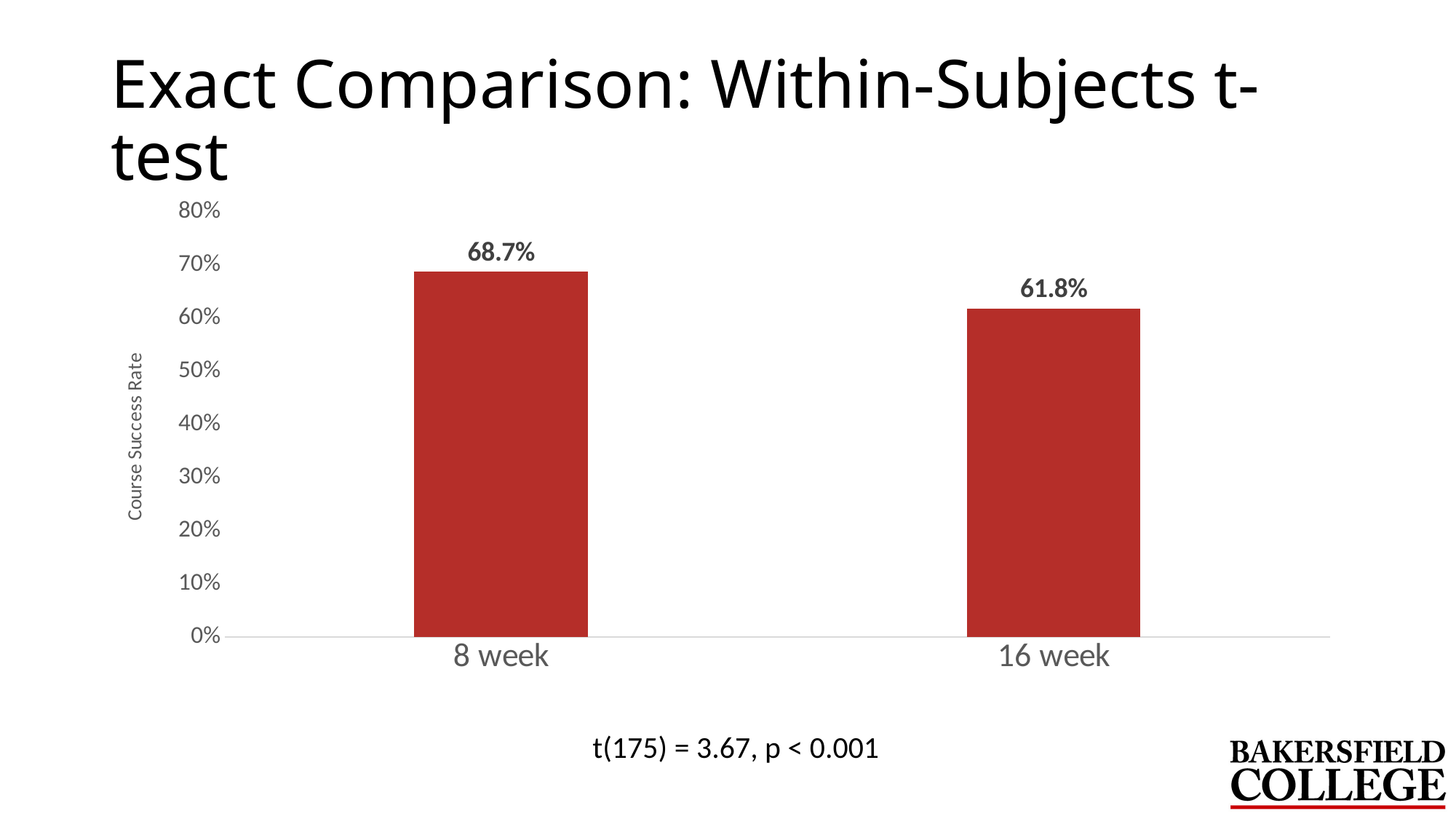
What is the difference between the 8 week and 16 week course success rates? 6.9% Which category has the lower course success rate? 16 week Is the course success rate higher for 8 week or 16 week courses? 8 week What is the course success rate for the 8 week category? 68.7% Is the value for 8 week greater or less than 60%? greater What is the course success rate for the 16 week category? 61.8% What kind of chart is shown on the slide? bar chart Which category has the higher course success rate? 8 week How many categories are shown on the x axis? 2 Is the value for 16 week greater or less than 70%? less Do the values rise or fall from 8 week to 16 week? fall What is the label of the y axis? Course Success Rate